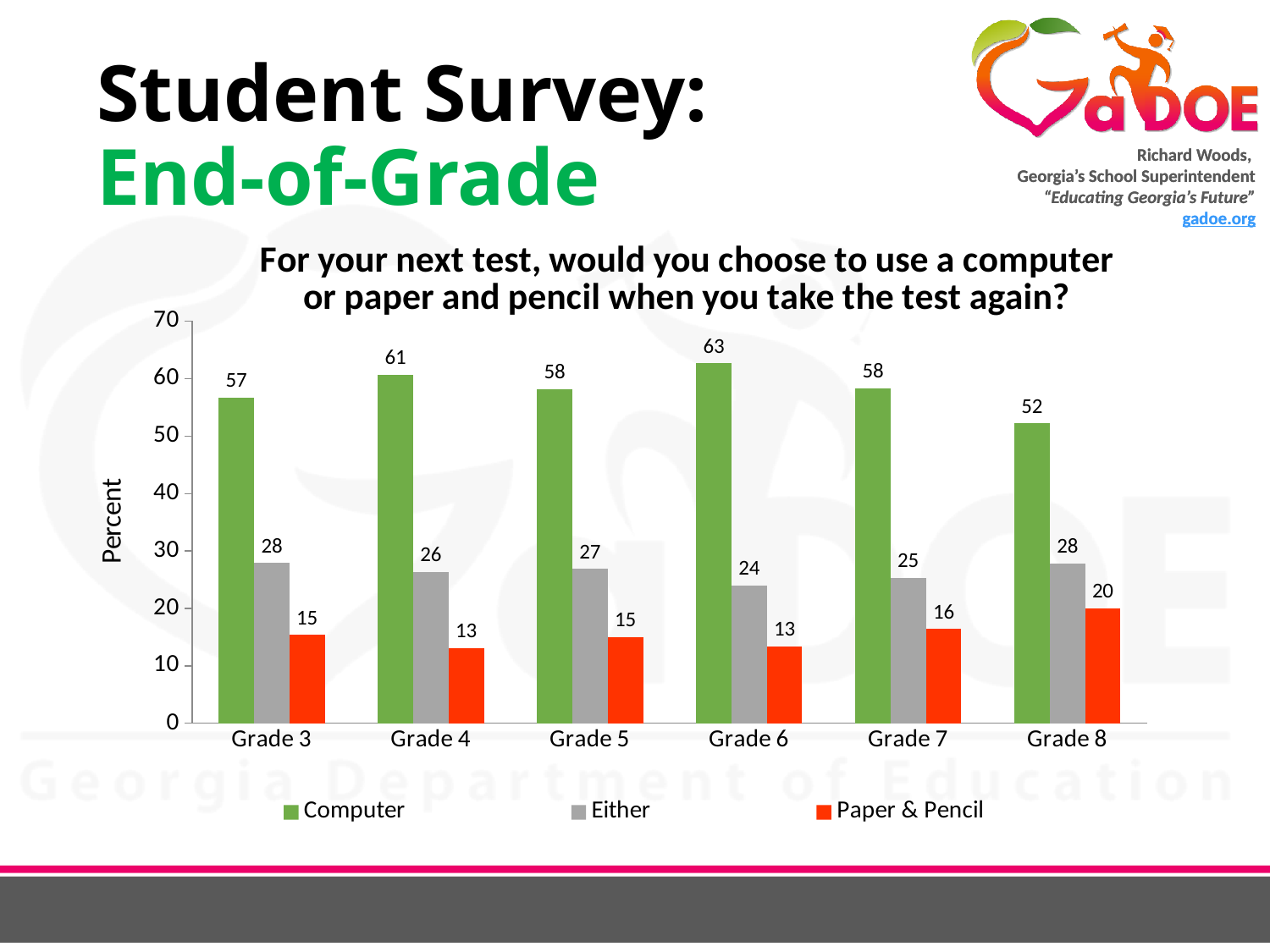
Which series is shown in orange in the legend? Paper & Pencil What kind of chart is shown on the slide? Bar chart What is the label on the vertical axis? Percent How many grades are shown on the x axis? 6 What is the value for Paper & Pencil in Grade 8? 20 Which grade has the lowest value for Computer? Grade 8 What is the difference between the Computer and Paper & Pencil values for Grade 3? 42 Which grade has the highest value for Computer? Grade 6 What percentage of Grade 6 students chose Computer? 63 What is the value for Either in Grade 4? 26 How many series does the legend list? 3 Which is larger for Grade 7: the Either value or the Paper & Pencil value? Either